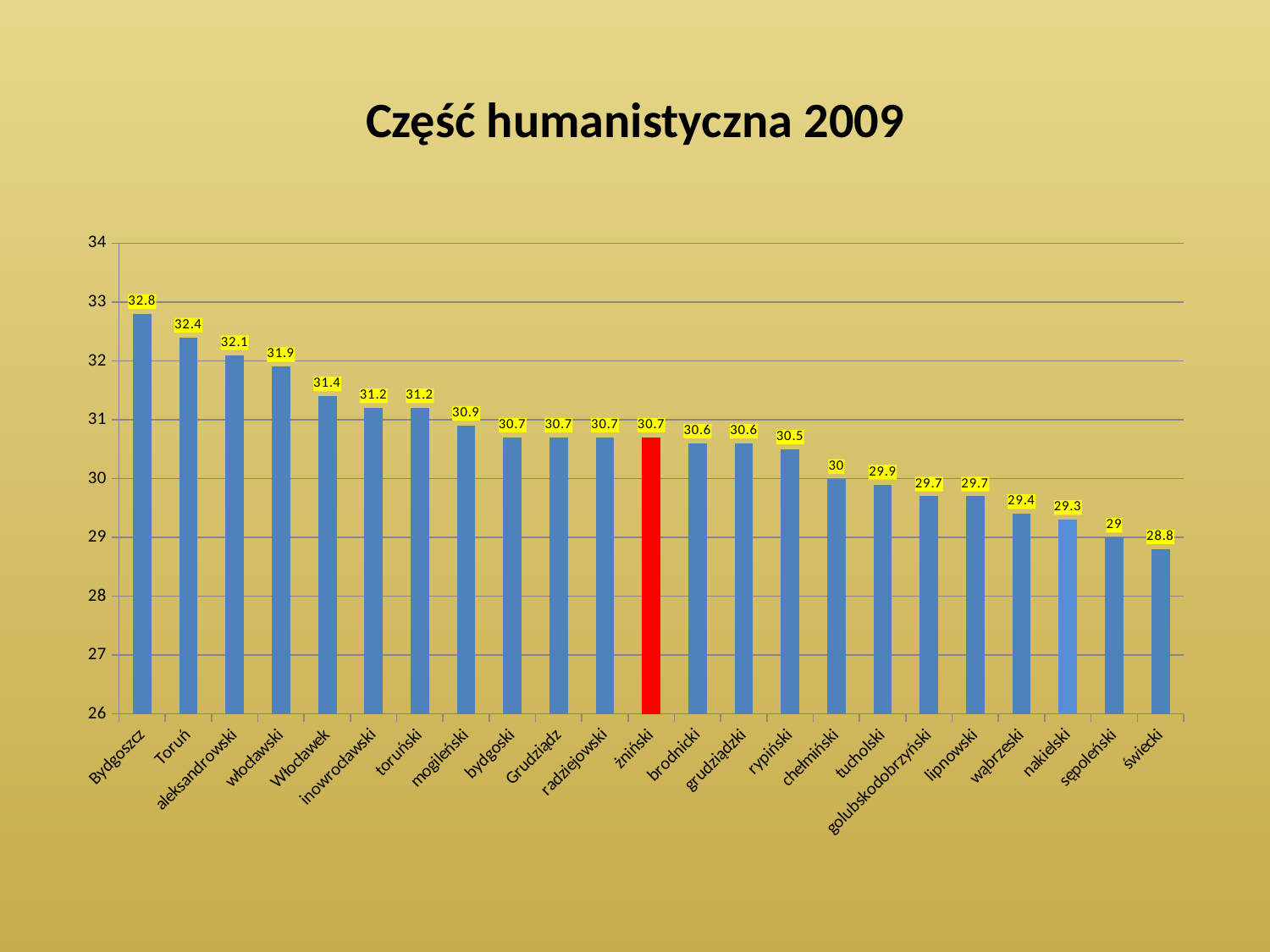
What is the difference between the values for Toruń and Włocławek? 1 What is the value for żniński? 30.7 Which category has the lowest value? świecki Which category has the highest value? Bydgoszcz What kind of chart is shown on the slide? bar chart Which is larger, the value for aleksandrowski or the value for rypiński? aleksandrowski How many categories are shown on the x axis? 23 What is the value for Bydgoszcz? 32.8 What is the value for świecki? 28.8 What is the difference between the values for Bydgoszcz and świecki? 4 What is the value for chełmiński? 30 Which bar is coloured red instead of blue? żniński